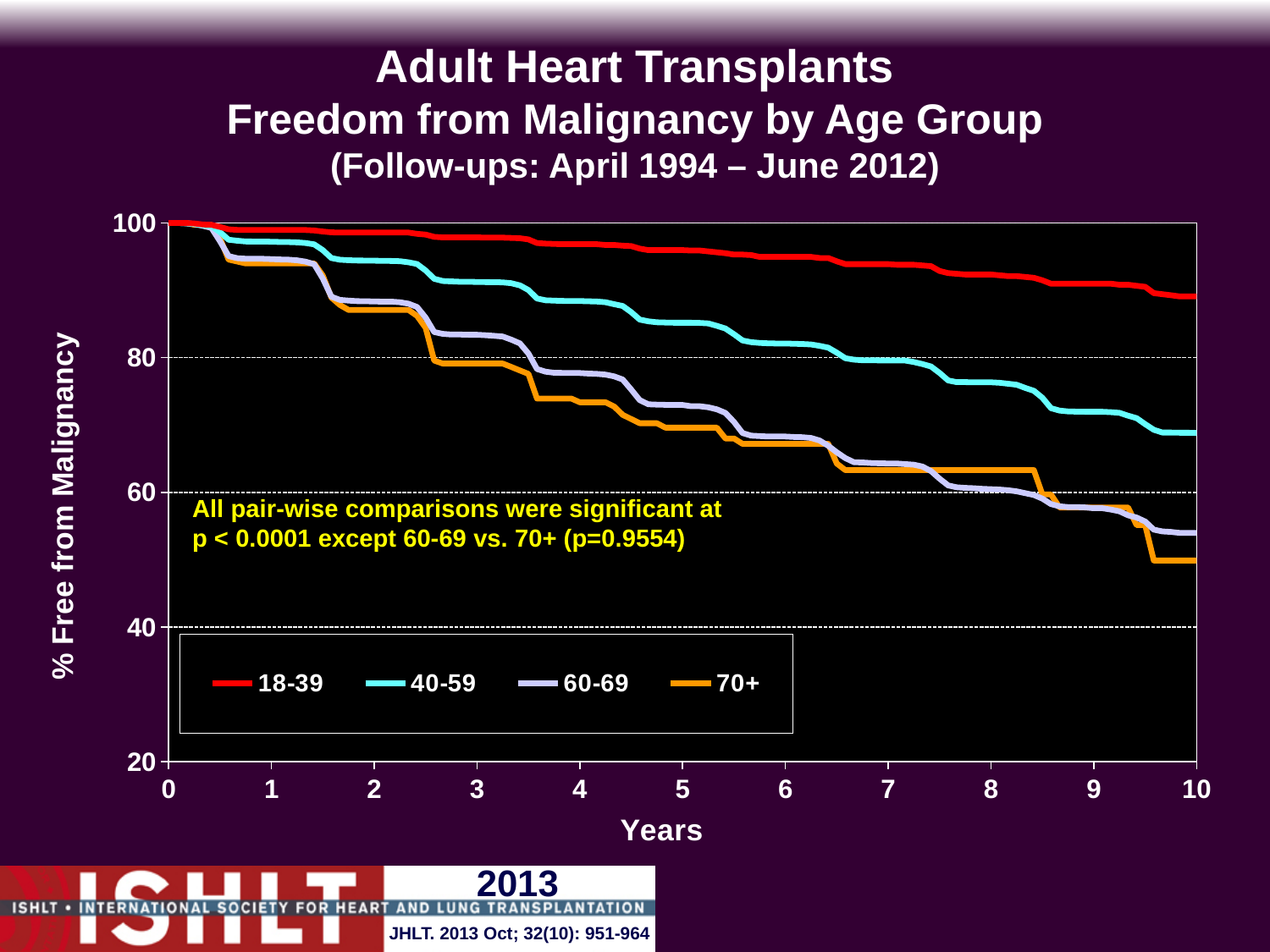
What is the title of the chart? Adult Heart Transplants Freedom from Malignancy by Age Group (Follow-ups: April 1994 – June 2012) What is the maximum value shown on the x axis (Years)? 10 Which age groups are listed in the legend? 18-39, 40-59, 60-69, 70+ Do the values for the 40-59 age group rise or fall as years increase? fall How many age groups does the legend list? 4 Which age group has the lowest % free from malignancy at 10 years? 70+ At 5 years, which has the higher % free from malignancy, the 40-59 group or the 60-69 group? 40-59 Is the value for the 18-39 age group at 10 years greater or less than 80? greater Is the value for the 40-59 age group at 10 years greater or less than 60? greater Which age group has the highest % free from malignancy at 10 years? 18-39 What kind of chart is shown on the slide? line chart Is the value for the 70+ age group at 10 years greater or less than 60? less